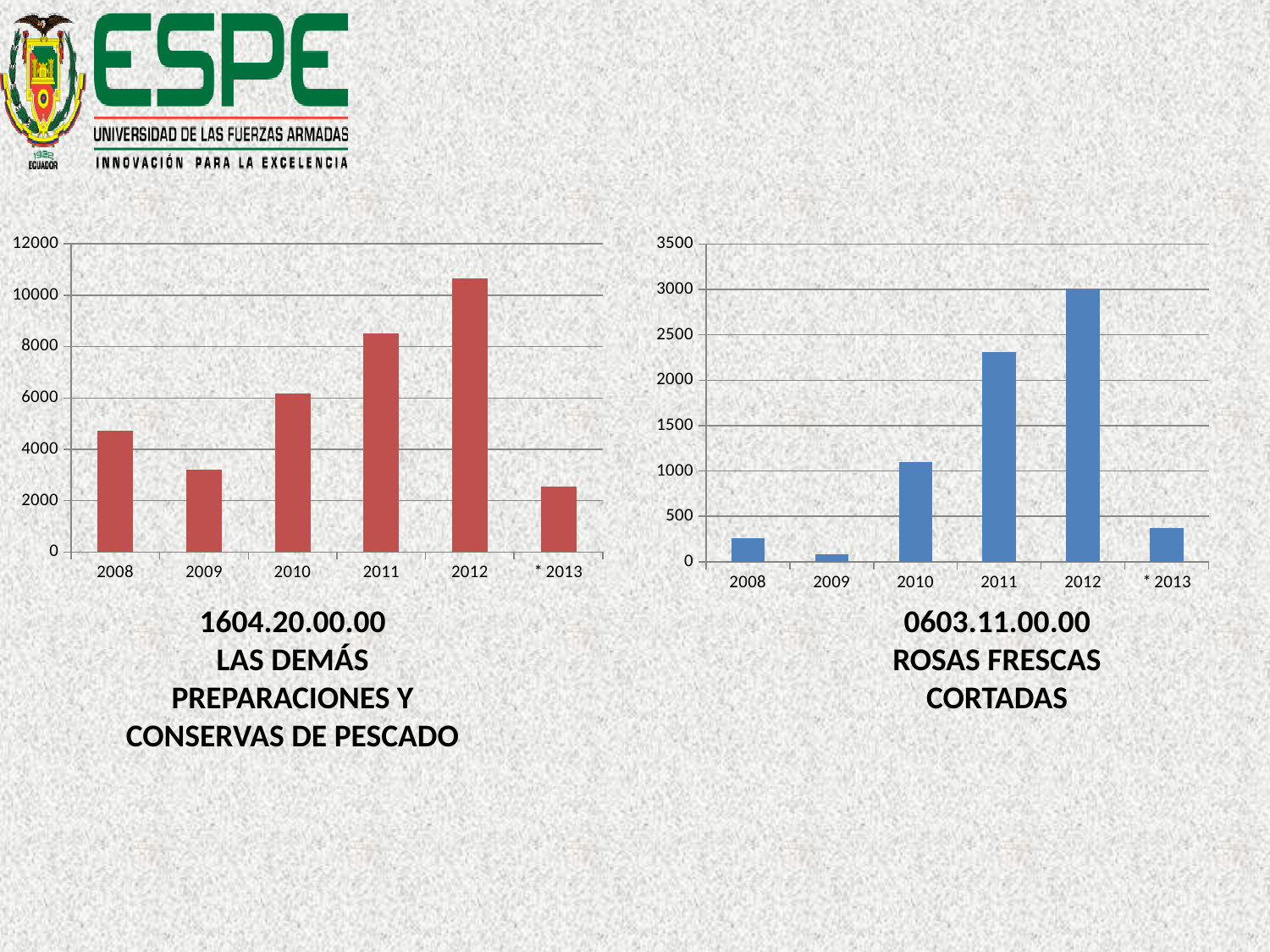
In the right chart (0603.11.00.00 Rosas frescas cortadas), do the values rise or fall from 2009 to 2012? rise In the left chart (1604.20.00.00 Las demás preparaciones y conservas de pescado), is the value for 2009 greater or less than 4000? less In the right chart (0603.11.00.00 Rosas frescas cortadas), which year has the highest bar? 2012 In the left chart (1604.20.00.00 Las demás preparaciones y conservas de pescado), which is larger, the value for 2008 or the value for 2010? 2010 In the left chart (1604.20.00.00 Las demás preparaciones y conservas de pescado), is the value for 2011 greater or less than 8000? greater In the right chart (0603.11.00.00 Rosas frescas cortadas), which year has the lowest bar? 2009 What kind of chart is the right chart (0603.11.00.00 Rosas frescas cortadas)? bar chart In the left chart (1604.20.00.00 Las demás preparaciones y conservas de pescado), which year has the lowest bar? * 2013 How many years are shown on the x axis of the left chart (1604.20.00.00 Las demás preparaciones y conservas de pescado)? 6 In the right chart (0603.11.00.00 Rosas frescas cortadas), is the value for 2008 greater or less than 500? less In the left chart (1604.20.00.00 Las demás preparaciones y conservas de pescado), which year has the highest bar? 2012